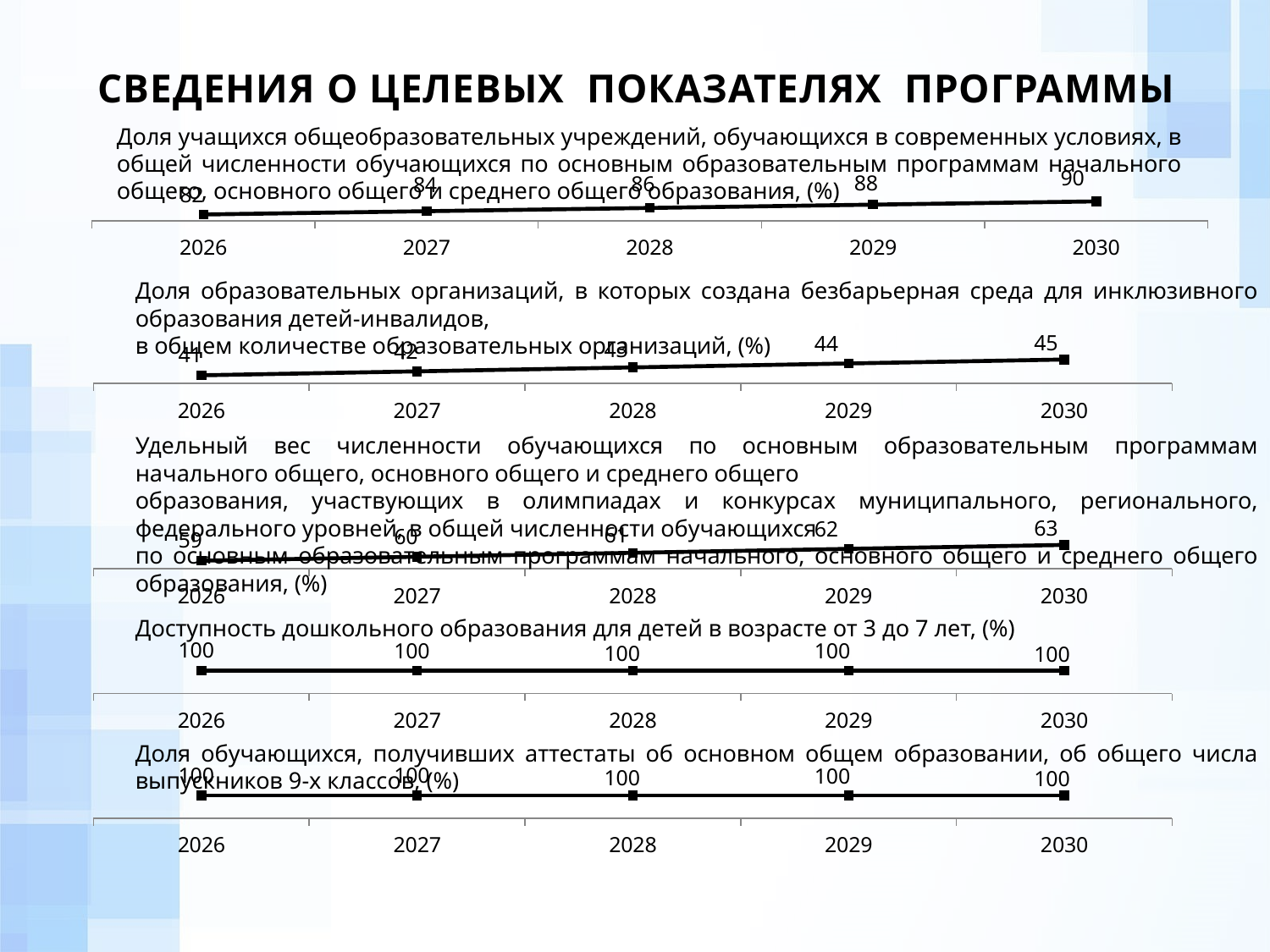
In the top chart (share of students studying in modern conditions), what is the difference between the 2030 and 2026 values? 8 In the top chart (share of students studying in modern conditions), what is the value for 2030? 90 In the bottom chart (share of students receiving certificates of basic general education), how many years are plotted on the x axis? 5 In the fourth chart from the top (availability of preschool education for children aged 3 to 7), what is the value for 2027? 100 In the third chart from the top (share of students participating in olympiads and competitions), do the values rise or fall from 2026 to 2030? rise In the top chart (share of students studying in modern conditions), what is the value for 2026? 82 In the second chart from the top (share of organisations with a barrier-free environment), what is the value for 2028? 43 How many charts are shown on the slide? 5 In the third chart from the top (share of students participating in olympiads and competitions), what is the value for 2029? 62 In the second chart from the top (share of organisations with a barrier-free environment), which year has the lowest value? 2026 In the top chart (share of students studying in modern conditions), which year has the highest value? 2030 What kind of chart is used for the indicators on this slide? line chart